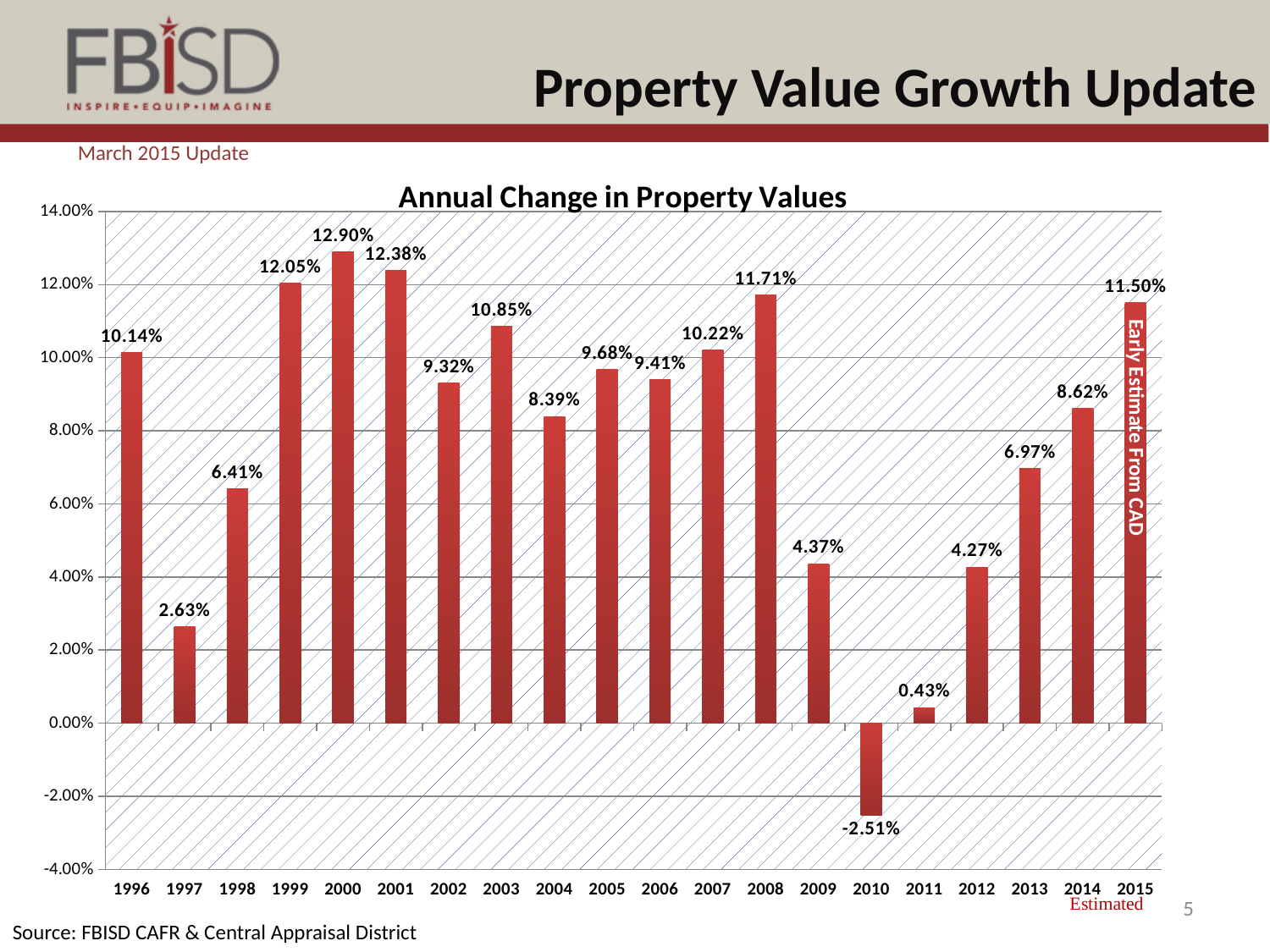
What is the difference between the annual change in 2000 and in 1999? 0.85% What is the title of the chart? Annual Change in Property Values Which year has the lowest annual change in property values? 2010 What is the estimated annual change in property values for 2015? 11.50% Which year has the highest annual change in property values? 2000 What is the annual change in property values shown for 2010? -2.51% How many years are shown on the x axis of the chart? 20 Do the annual change values rise or fall from 2010 to 2015? Rise Which year has a larger annual change in property values, 2003 or 2002? 2003 What is the annual change in property values for 2000? 12.90% What is the difference between the 2015 estimate and the 2014 value? 2.88% What kind of chart is used to show the annual change in property values? Bar chart